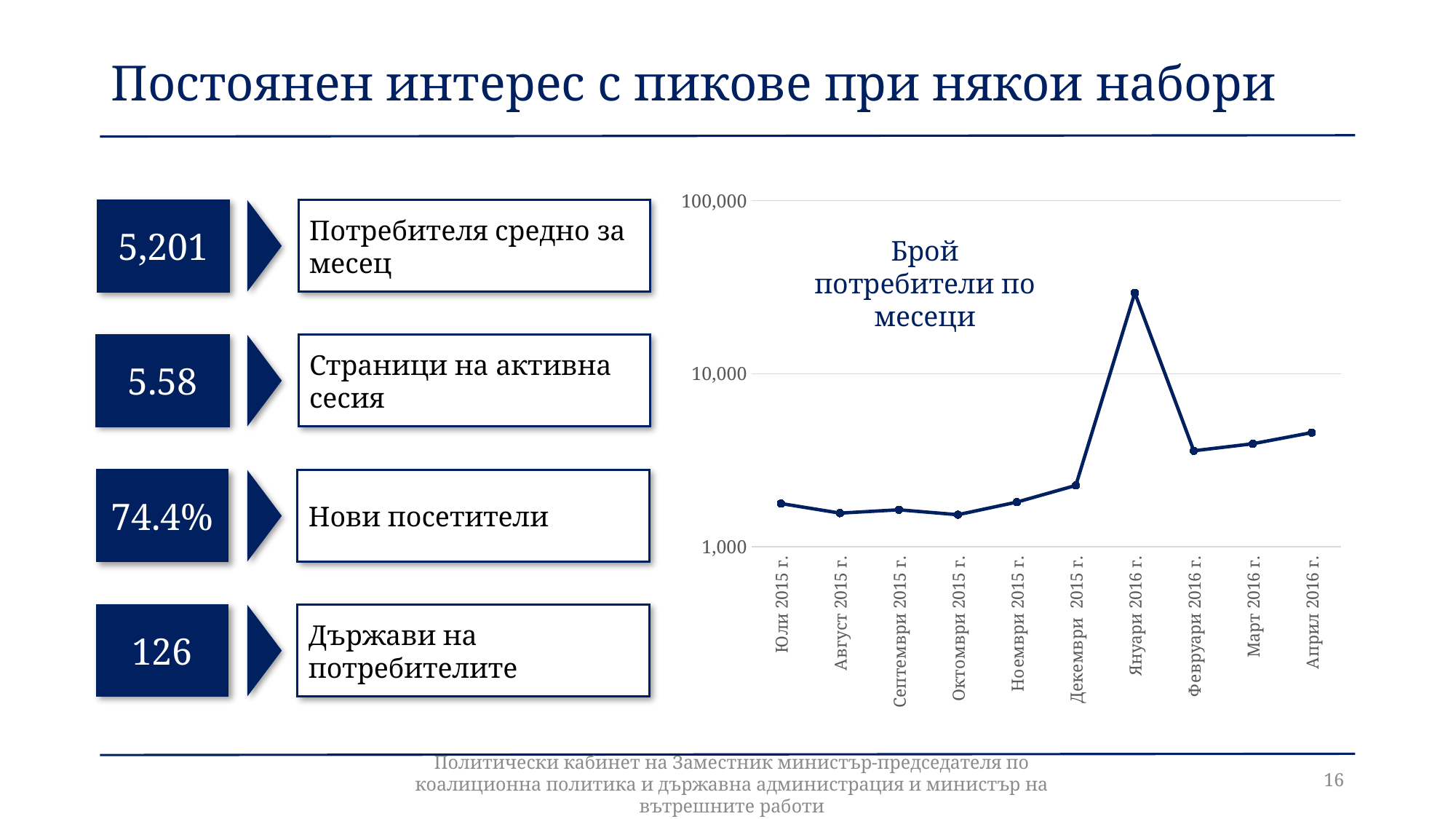
Which is larger, the value for Януари 2016 г. or the value for Февруари 2016 г.? Януари 2016 г. Which is larger, the value for Декември 2015 г. or the value for Ноември 2015 г.? Декември 2015 г. Does the number of users rise or fall from Януари 2016 г. to Февруари 2016 г.? fall What is the highest value shown on the chart's vertical axis? 100,000 Is the value for Юли 2015 г. greater or less than 10,000? less How many months are plotted on the chart? 10 Is the value for Януари 2016 г. greater or less than 10,000? greater What is the title of the chart on the slide? Брой потребители по месеци Which month has the highest number of users on the chart? Януари 2016 г. What kind of chart is shown on the slide? line chart Is the value for Януари 2016 г. greater or less than 100,000? less